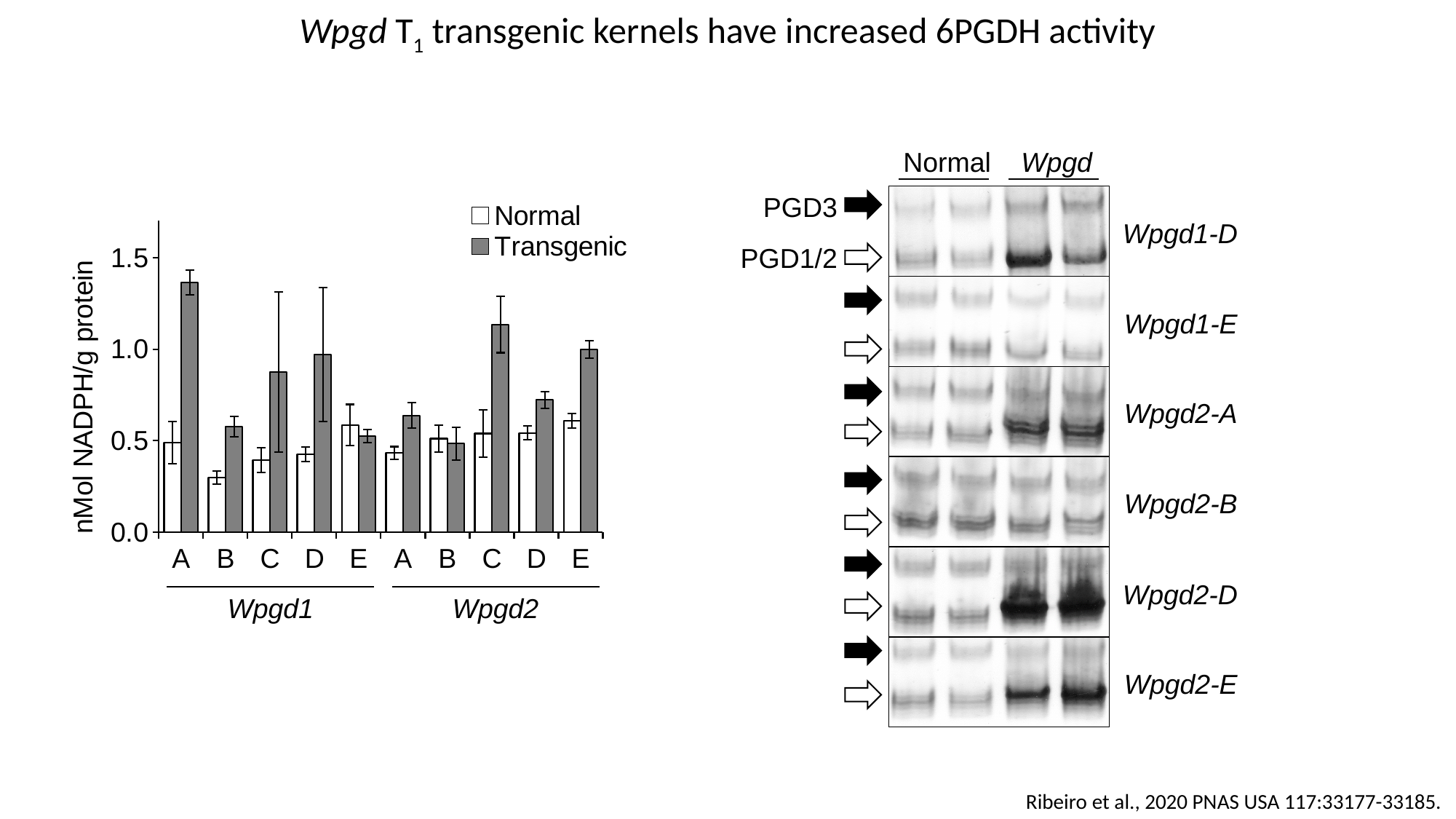
How many categories (lettered groups) are shown along the x axis of the bar chart? 10 How many series does the legend of the bar chart list? 2 What is the y-axis label of the bar chart? nMol NADPH/g protein In the bar chart, is the Transgenic value for Wpgd1 B greater or less than 0.5? greater In the bar chart, for Wpgd2 D, which is larger: the Normal value or the Transgenic value? Transgenic In the bar chart, which category has the lowest Normal value? Wpgd1 B In the bar chart, which category has the highest Transgenic value? Wpgd1 A In the bar chart, is the Transgenic value for Wpgd1 A greater or less than 1.0? greater In the bar chart, is the Normal value for Wpgd1 B greater or less than 0.5? less What kind of chart is shown on the left of the slide? bar chart In the bar chart, for Wpgd2 C, which is larger: the Normal value or the Transgenic value? Transgenic